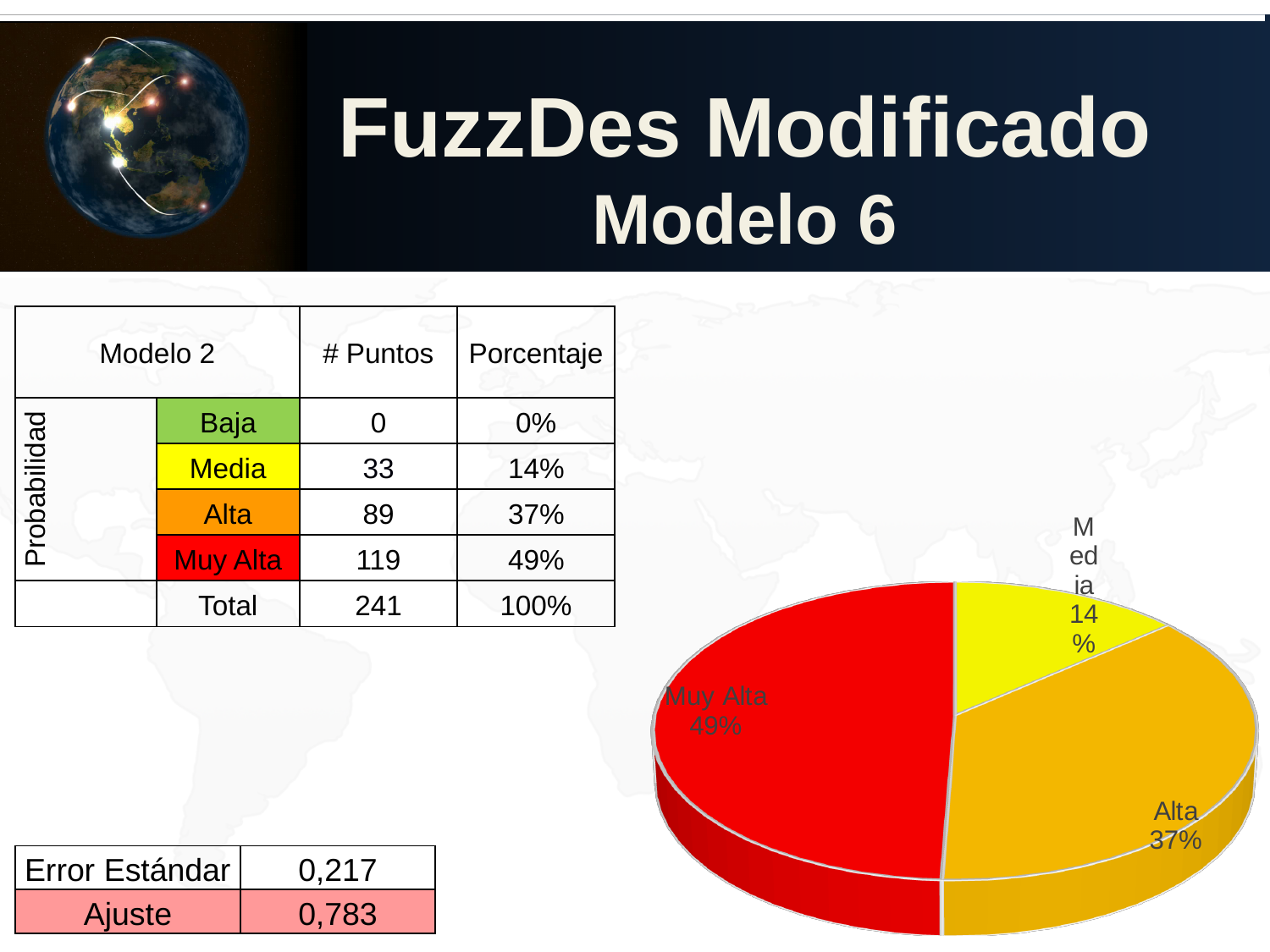
What colour is the Muy Alta slice in the pie chart? red In the pie chart, which is larger, the Alta slice or the Media slice? Alta Which slice of the pie chart is the largest? Muy Alta What share of the pie chart does the Muy Alta slice represent? 49% What colour is the Media slice in the pie chart? yellow In the pie chart, what is the difference in percentage points between the Alta slice and the Media slice? 23% How many labeled slices does the pie chart have? 3 What share of the pie chart does the Media slice represent? 14% In the pie chart, what is the difference in percentage points between the Muy Alta slice and the Alta slice? 12% Which slice of the pie chart is the smallest? Media What share of the pie chart does the Alta slice represent? 37% What kind of chart is shown on the slide? pie chart